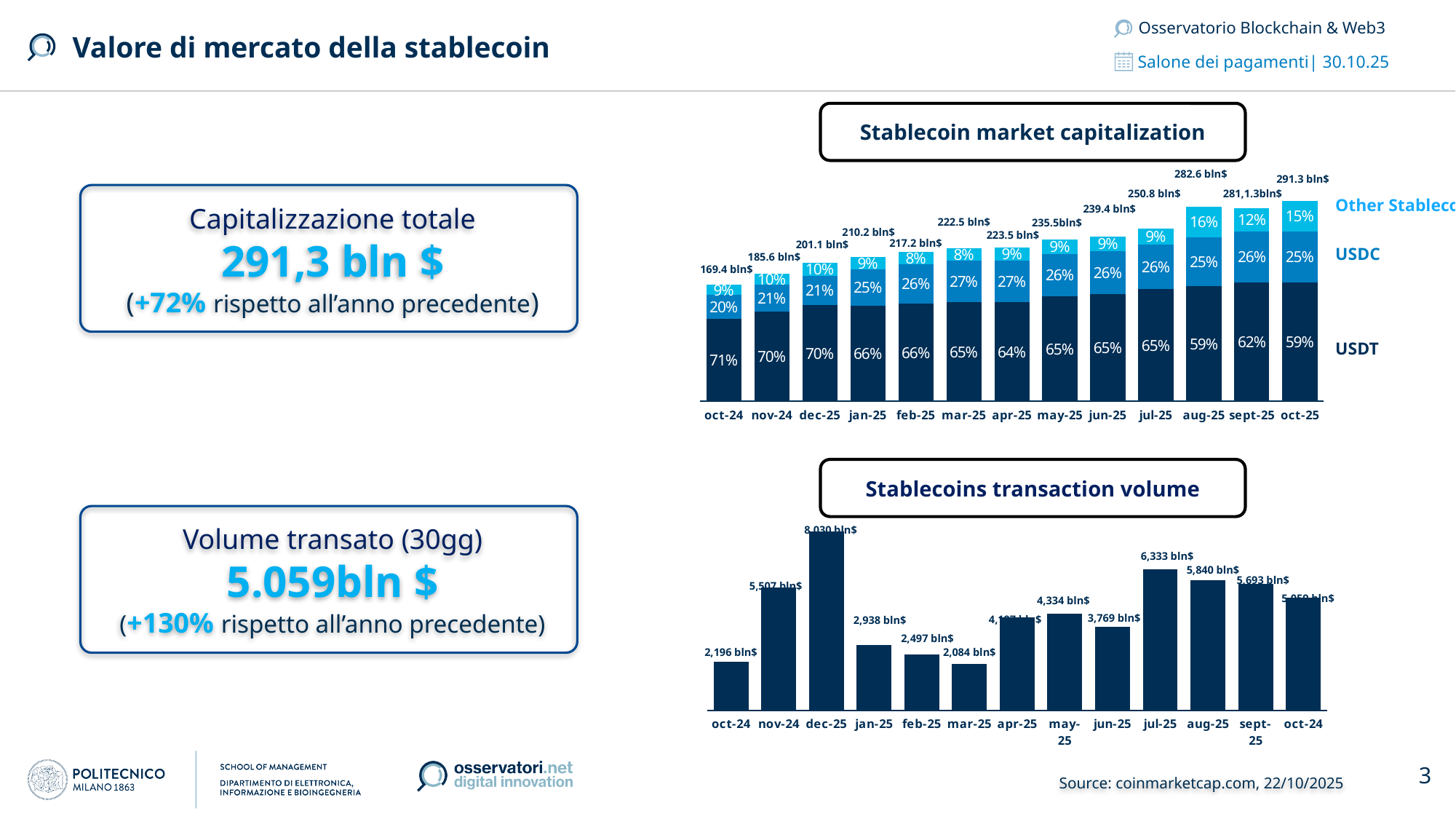
In the 'Stablecoin market capitalization' chart, what is the difference between the total for oct-25 and the total for oct-24? 121.9 bln$ In the 'Stablecoin market capitalization' chart, what is the Other Stablecoins share in aug-25? 16% In the 'Stablecoin market capitalization' chart, what is the total market capitalization for oct-25? 291.3 bln$ In the 'Stablecoins transaction volume' chart, which month has the highest transaction volume? dec-25 In the 'Stablecoins transaction volume' chart, what is the difference between the volume for jul-25 and the volume for jun-25? 2,564 bln$ How many series does the legend of the 'Stablecoin market capitalization' chart list? 3 In the 'Stablecoin market capitalization' chart, does the USDT share rise or fall from oct-24 to oct-25? Fall In the 'Stablecoin market capitalization' chart, what is the USDT share in oct-24? 71% What kind of chart is the 'Stablecoin market capitalization' chart? Stacked bar chart In the 'Stablecoins transaction volume' chart, which is larger: the volume for nov-24 or the volume for aug-25? aug-25 In the 'Stablecoin market capitalization' chart, which month has the lowest total market capitalization? oct-24 In the 'Stablecoins transaction volume' chart, what is the transaction volume for jul-25? 6,333 bln$